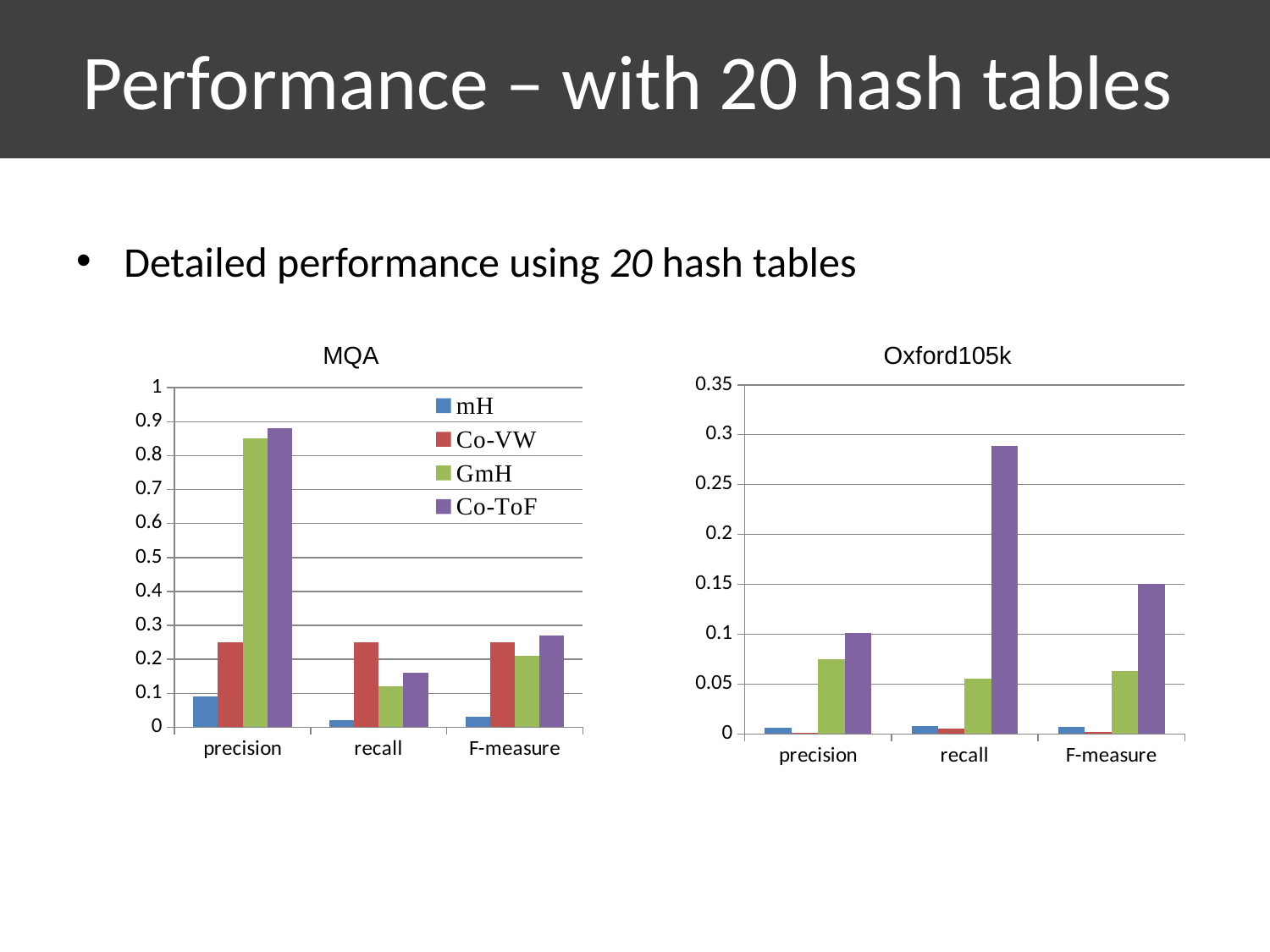
How many series does the legend of the MQA chart list? 4 How many categories are shown on the x axis of the Oxford105k chart? 3 In the MQA chart, which series has the lowest value for recall? mH In the MQA chart, which is larger for F-measure: Co-ToF or GmH? Co-ToF In the Oxford105k chart, is the purple (Co-ToF) bar for recall greater or less than 0.25? greater In the Oxford105k chart, which bar is the tallest for recall? Co-ToF (purple) In the MQA chart, which series has the highest value for recall? Co-VW In the MQA chart, is the GmH value for precision greater or less than 0.8? greater What is the title of the chart on the right side of the slide? Oxford105k In the Oxford105k chart, which is larger for precision: the green (GmH) bar or the purple (Co-ToF) bar? purple (Co-ToF) What kind of chart is the MQA chart? bar chart In the MQA chart, is the Co-VW value for recall greater or less than 0.2? greater